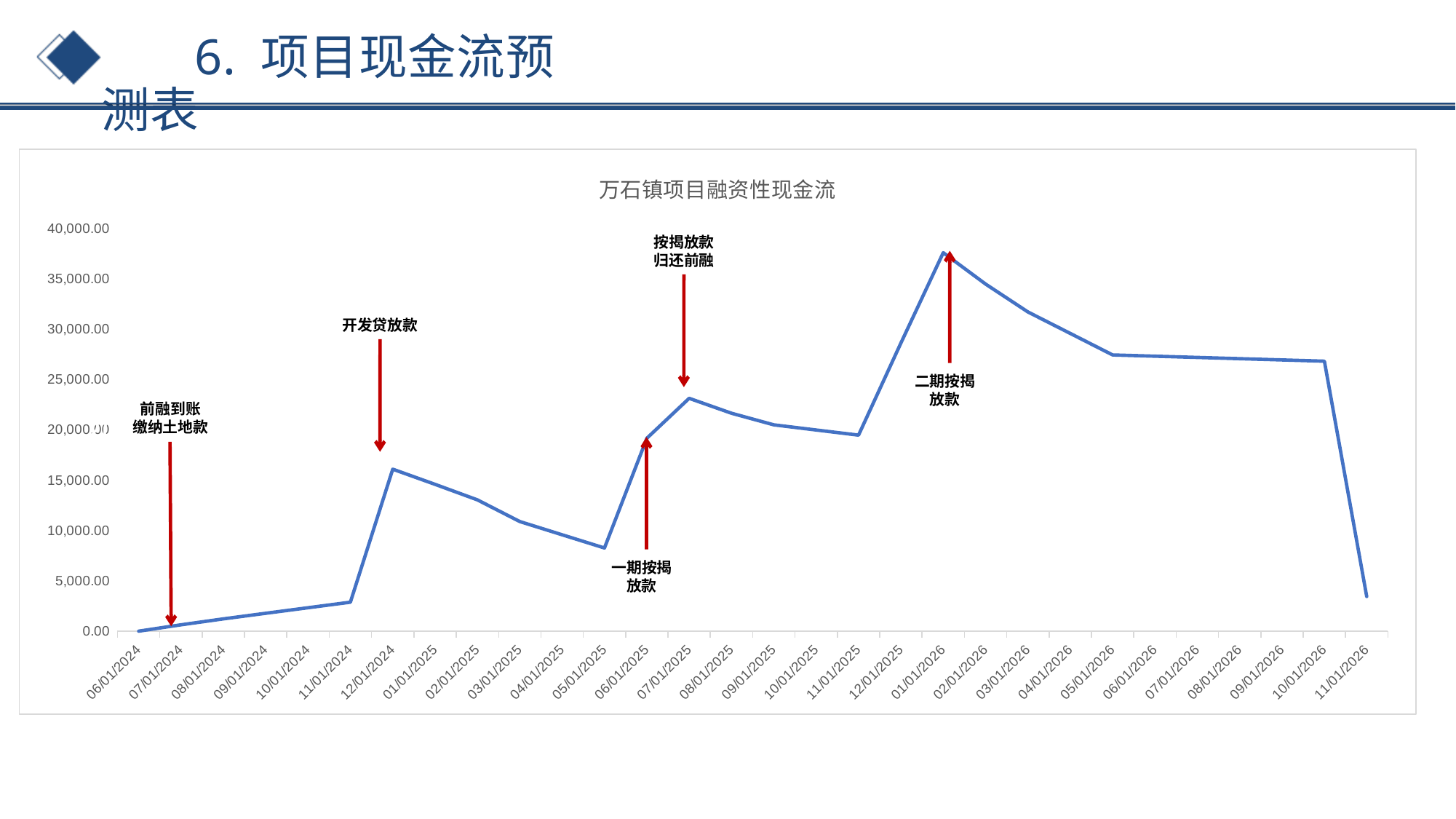
On which date does the line have its lowest value? 06/01/2024 Is the value for 12/01/2024 greater or less than 15,000.00? greater Which annotation label points to the peak of the line at 01/01/2026? 二期按揭放款 What kind of chart is shown on the slide? line chart Do the values rise or fall between 01/01/2026 and 10/01/2026? fall Is the value for 11/01/2026 greater or less than 5,000.00? less Is the value for 01/01/2026 greater or less than 35,000.00? greater On which date does the line reach its highest value? 01/01/2026 Which date has the larger value, 12/01/2024 or 07/01/2025? 07/01/2025 How many dates are shown on the x axis of the chart? 30 What is the title of the chart? 万石镇项目融资性现金流